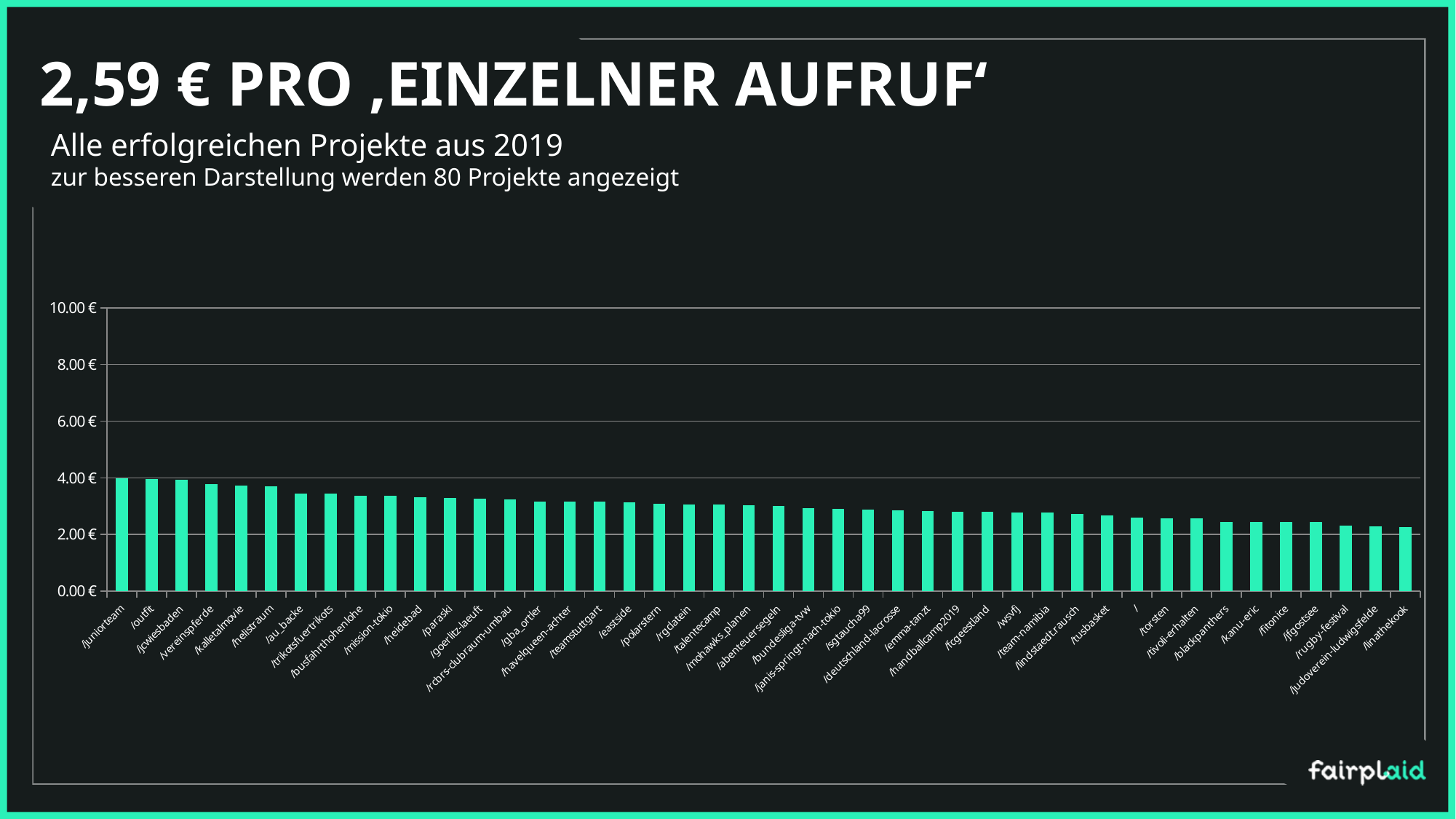
What is the highest tick value shown on the y axis? 10.00 € Which has the larger value, /rugby-festival or /vereinspferde? /vereinspferde Is the value for /juniorteam greater or less than 2.00 €? greater Is the value for /outfit greater or less than 8.00 €? less Do the bar values rise or fall from left to right along the x axis? fall Which has the larger value, /juniorteam or /linathekook? /juniorteam Is the value for /tusbasket greater or less than 4.00 €? less Which has the larger value, /outfit or /tusbasket? /outfit What kind of chart is shown on the slide? bar chart What is the title of the slide containing the chart? 2,59 € PRO ‚EINZELNER AUFRUF‘